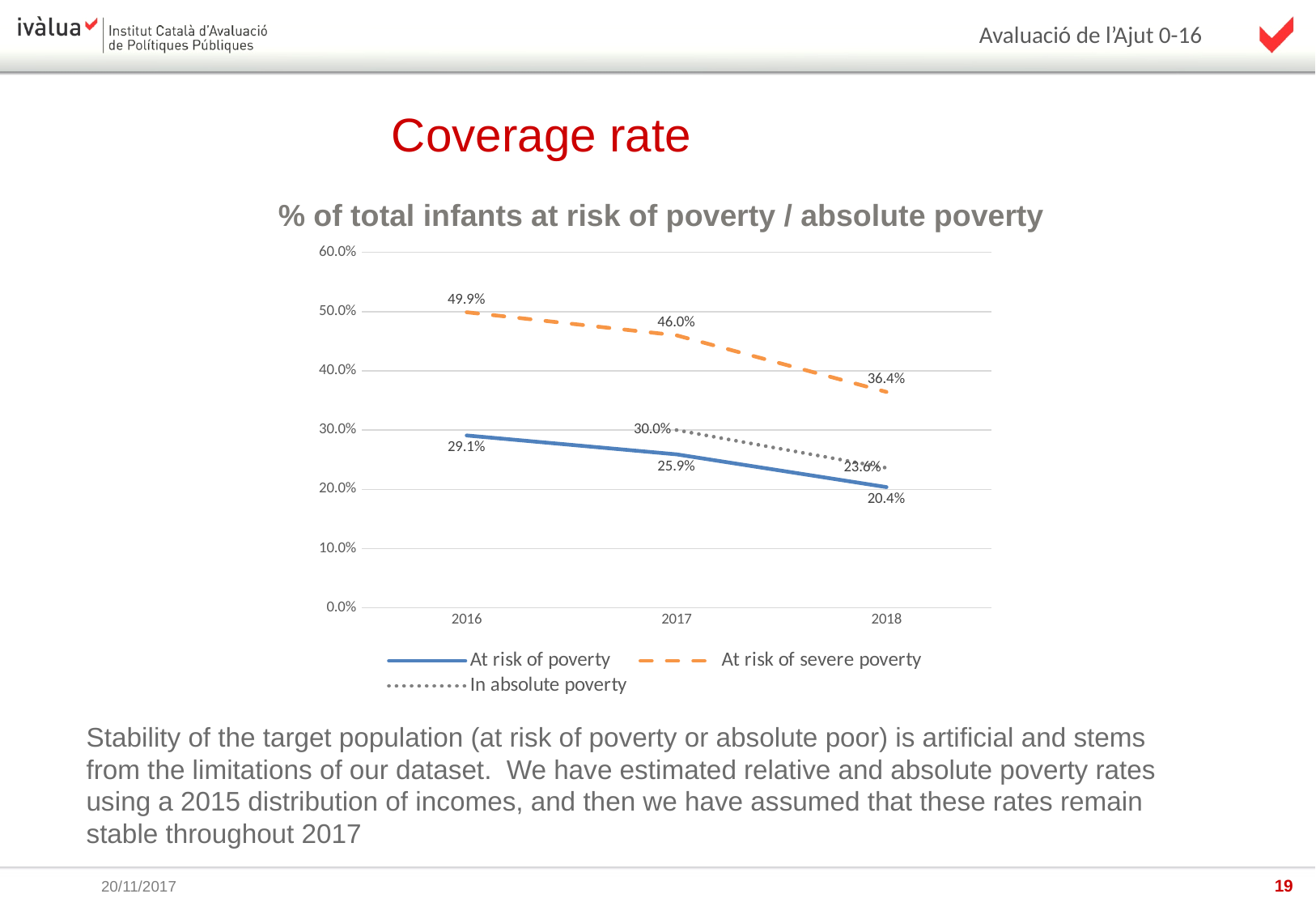
What is the value for 'At risk of severe poverty' in 2016? 49.9% What kind of chart is shown on the slide? Line chart What is the value for 'At risk of poverty' in 2018? 20.4% Which series has the highest value in 2018? At risk of severe poverty How many series does the legend list? 3 In which year is the 'At risk of severe poverty' series lowest? 2018 What is the value for 'In absolute poverty' in 2017? 30.0% Which is larger in 2018: 'In absolute poverty' or 'At risk of poverty'? In absolute poverty How many years are shown on the x axis? 3 What is the difference between the 'At risk of severe poverty' values in 2016 and 2018? 13.5% What is the value for 'At risk of poverty' in 2017? 25.9% Does the 'At risk of poverty' series rise or fall from 2016 to 2018? Fall